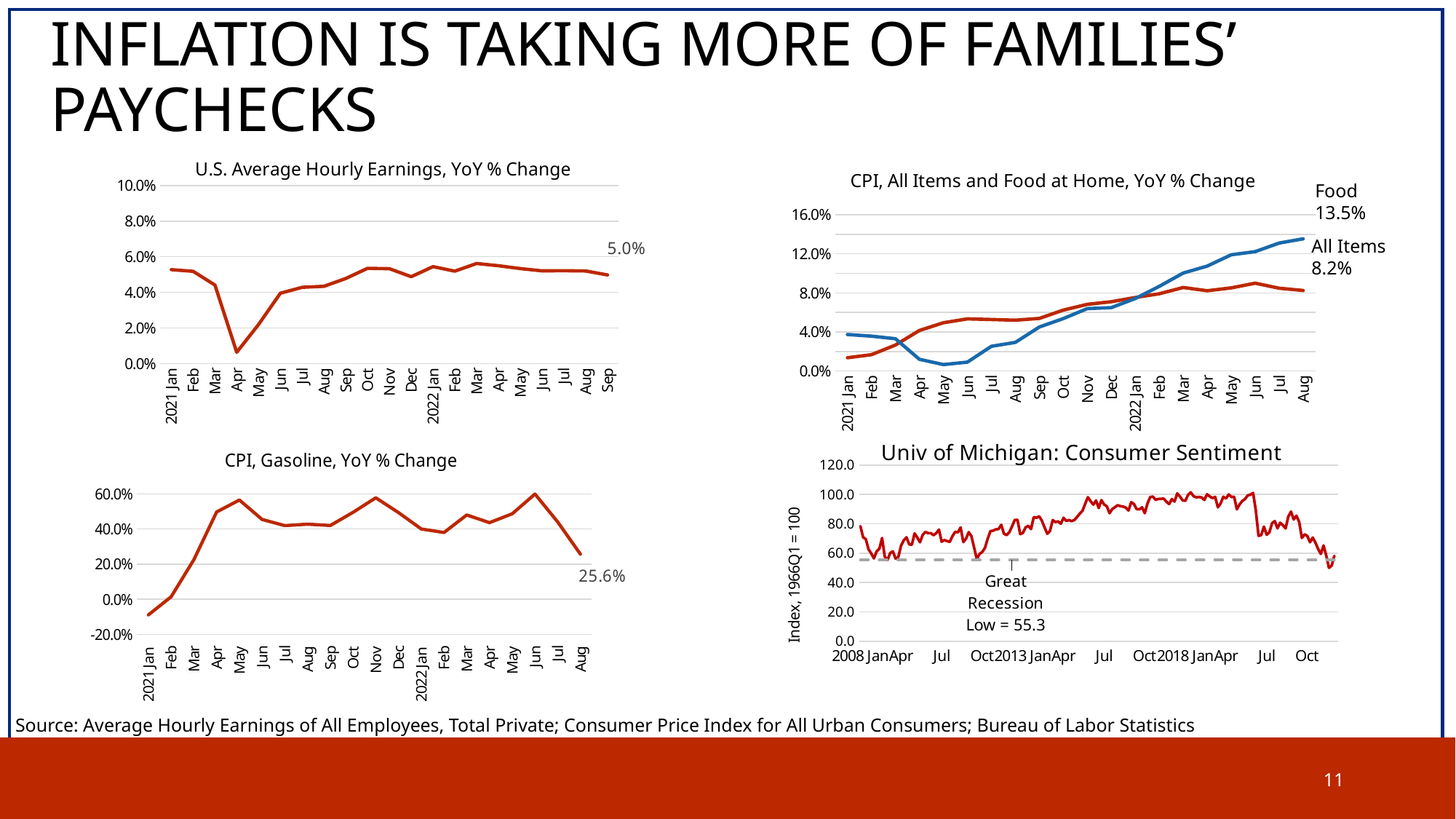
In the CPI, Gasoline chart, is the value for Jun 2022 greater or less than 40.0%? greater In the CPI, All Items and Food at Home chart, what is the labeled value for Food at the end of the series? 13.5% In the CPI, All Items and Food at Home chart, which series has the higher labeled value at the end of the series, Food or All Items? Food How many series are plotted in the CPI, All Items and Food at Home chart? 2 In the CPI, All Items and Food at Home chart, what is the labeled value for All Items at the end of the series? 8.2% In the CPI, Gasoline chart, what is the labeled value for the final point (Aug 2022)? 25.6% In the CPI, All Items and Food at Home chart, what is the difference between the labeled Food value and the labeled All Items value? 5.3% In the U.S. Average Hourly Earnings chart, what is the labeled value for the final point (Sep 2022)? 5.0% What kind of chart is the U.S. Average Hourly Earnings, YoY % Change chart? Line chart In the CPI, Gasoline chart, do the values rise or fall from Jun 2022 to Aug 2022? fall In the U.S. Average Hourly Earnings chart, is the value for Apr 2021 greater or less than 2.0%? less In the Univ of Michigan: Consumer Sentiment chart, what value is given for the Great Recession low? 55.3